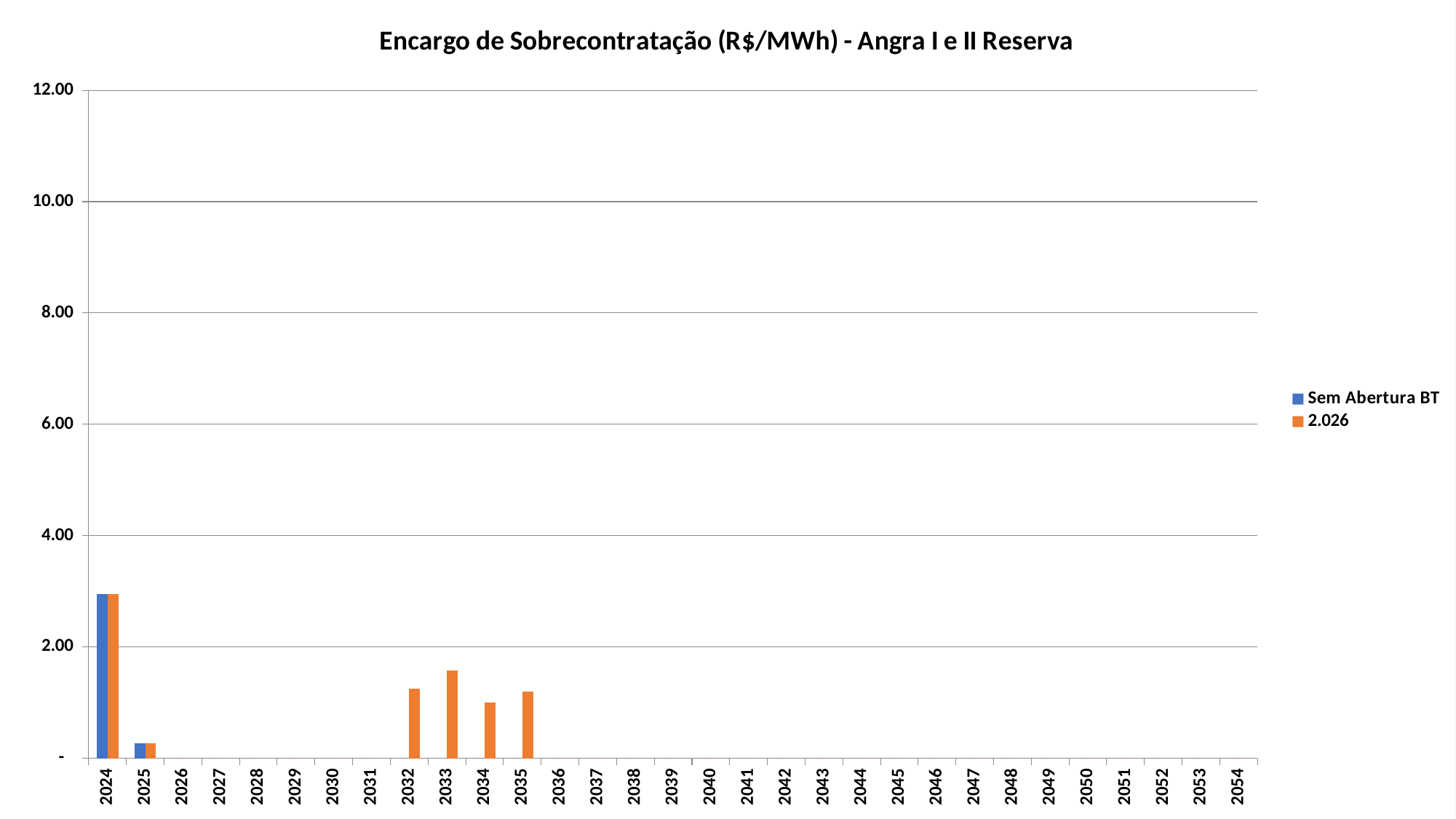
Is the value for 2033 in the 2.026 series greater or less than 2.00? less Is the value for 2024 in the 2.026 series greater or less than 2.00? greater What kind of chart is shown on the slide? bar chart Which year has the highest value for the Sem Abertura BT series? 2024 In the 2.026 series, which is larger: the value for 2033 or the value for 2034? 2033 What are the two series named in the legend? Sem Abertura BT and 2.026 Which year has the highest value for the 2.026 series? 2024 Is the value for 2025 in the Sem Abertura BT series greater or less than 2.00? less How many series does the legend list? 2 What is the title of the chart? Encargo de Sobrecontratação (R$/MWh) - Angra I e II Reserva In the 2.026 series, which is larger: the value for 2024 or the value for 2032? 2024 How many years are shown on the x axis? 31